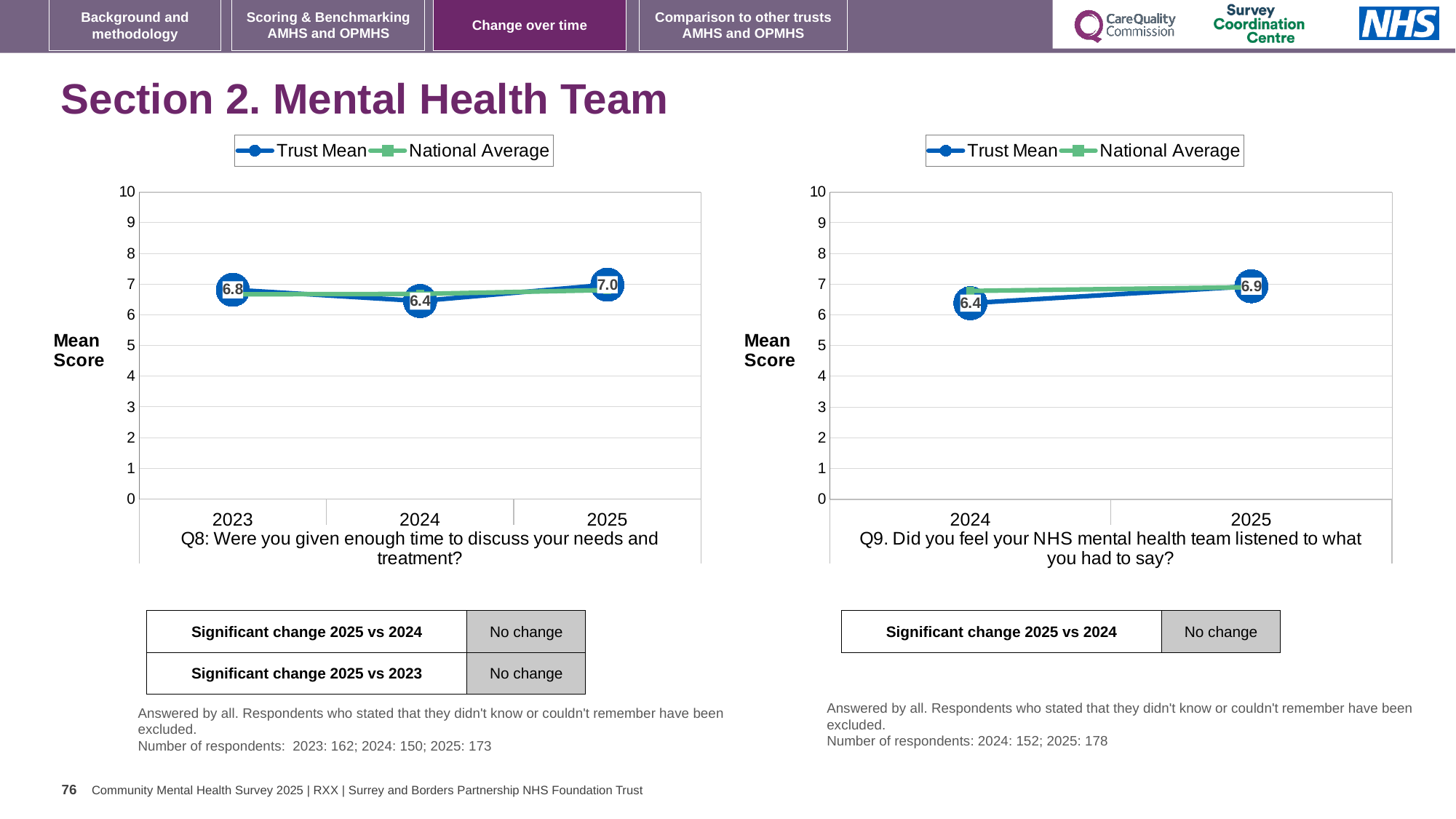
On the Q9 chart (right), what is the difference between the Trust Mean scores for 2025 and 2024? 0.5 On the Q8 chart (left), is the Trust Mean score for 2023 or 2025 larger? 2025 On the Q9 chart (right), what is the Trust Mean score for 2024? 6.4 On the Q8 chart (left), what is the Trust Mean score for 2025? 7.0 On the Q8 chart (left), what is the Trust Mean score for 2023? 6.8 On the Q9 chart (right), how many years are plotted on the x axis? 2 On the Q8 chart (left), how many series does the legend list? 2 What type of chart is used for Q9 (right)? Line chart On the Q8 chart (left), which year has the lowest Trust Mean score? 2024 On the Q8 chart (left), which year has the highest Trust Mean score? 2025 On the Q9 chart (right), what is the Trust Mean score for 2025? 6.9 On the Q8 chart (left), what is the Trust Mean score for 2024? 6.4